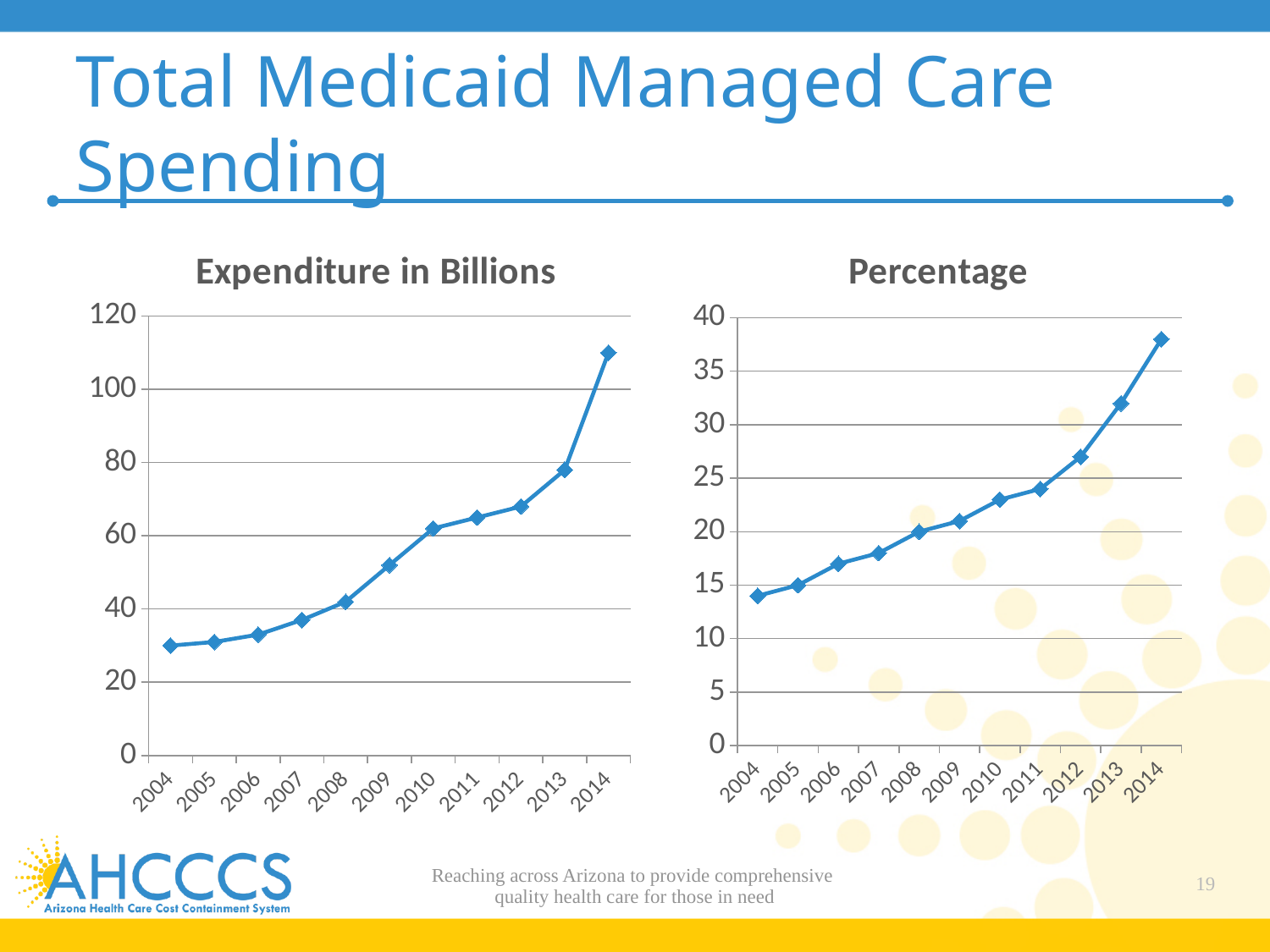
Do the values on the 'Percentage' chart rise or fall from 2004 to 2014? rise What kind of chart is the 'Expenditure in Billions' chart? line chart On the 'Expenditure in Billions' chart, is the value for 2014 greater or less than 100? greater On the 'Percentage' chart, what is the value for 2008? 20 How many years are plotted on the 'Percentage' chart? 11 On the 'Percentage' chart, is the value for 2013 greater or less than 30? greater On the 'Expenditure in Billions' chart, which year has the highest value? 2014 On the 'Expenditure in Billions' chart, which year has the lowest value? 2004 What is the title of the chart on the right side of the slide? Percentage On the 'Percentage' chart, is the value for 2014 greater or less than 35? greater On the 'Percentage' chart, which year has the highest value? 2014